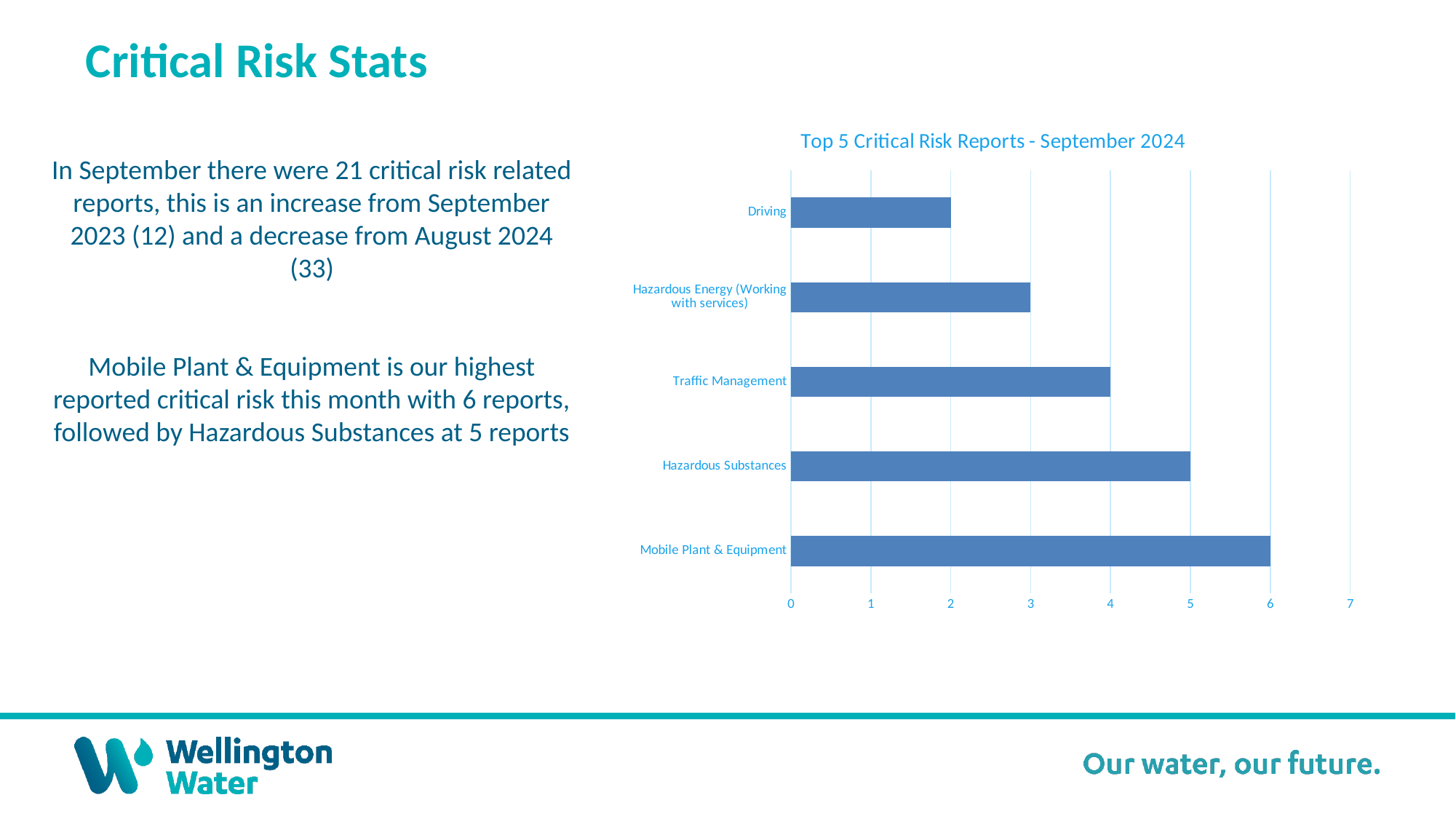
What is the value for Driving? 2 What is the difference between the values for Mobile Plant & Equipment and Driving? 4 What is the title of the chart? Top 5 Critical Risk Reports - September 2024 What is the value for Traffic Management? 4 Which is larger, the value for Traffic Management or the value for Hazardous Energy (Working with services)? Traffic Management How many categories are plotted in the chart? 5 What kind of chart is shown on the slide? bar chart What is the value for Mobile Plant & Equipment? 6 What is the value for Hazardous Energy (Working with services)? 3 What is the value for Hazardous Substances? 5 Which category has the highest value in the chart? Mobile Plant & Equipment Which category has the lowest value in the chart? Driving